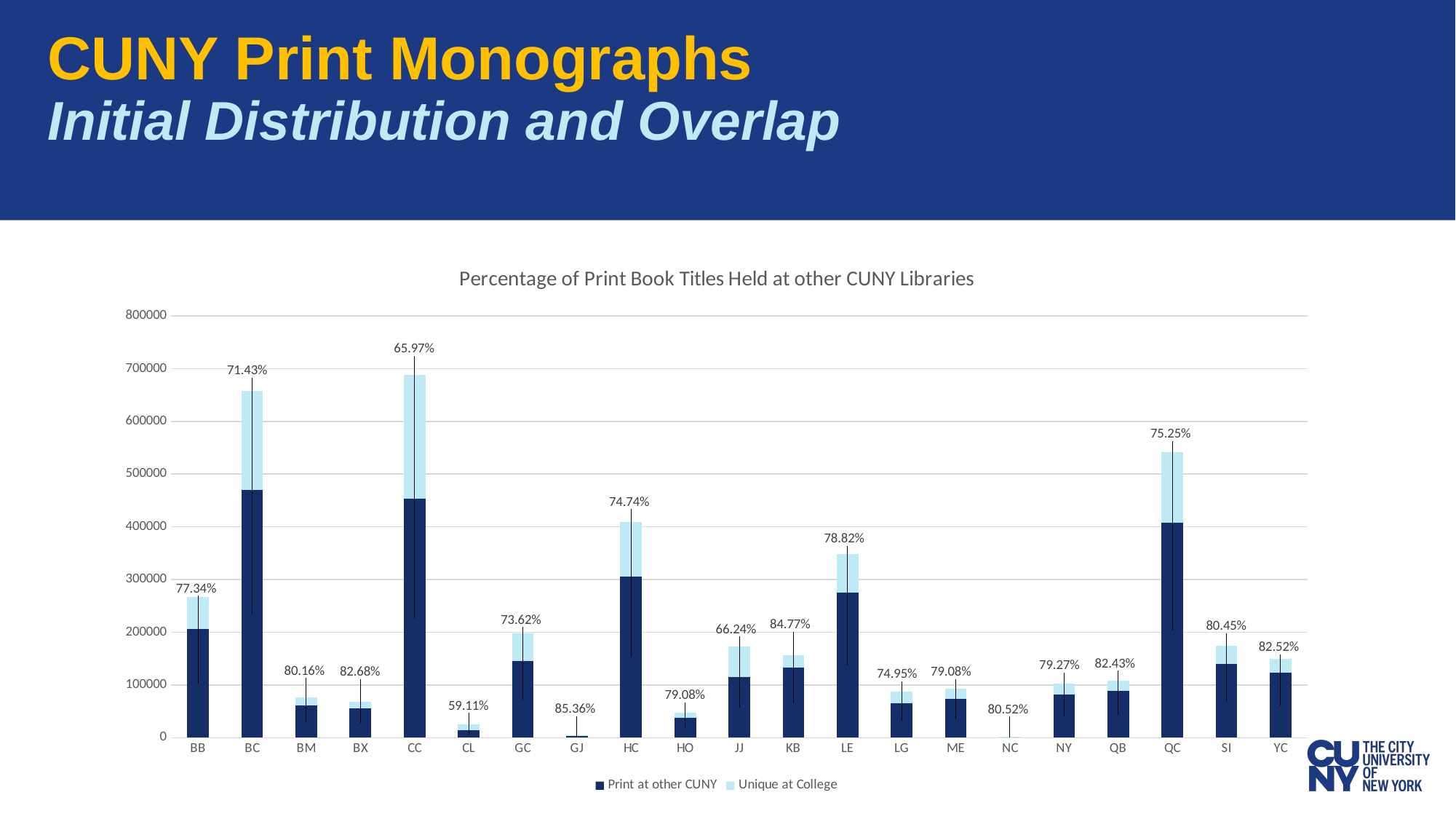
What percentage label is shown above the bar for LE? 78.82% What is the difference between the percentage labels for BB and BC? 5.91% What percentage label is shown above the bar for CC? 65.97% How many series does the legend list? 2 What percentage label is shown above the bar for GJ? 85.36% Which college has the lowest percentage label on the chart? CL Which college has the highest percentage label on the chart? GJ Is the total stacked bar for QC greater or less than 500000? greater How many colleges are shown on the x axis? 21 Is the total stacked bar for HC greater or less than 500000? less Which stacked bar is taller, BC or QC? BC Which college has the tallest stacked bar overall? CC